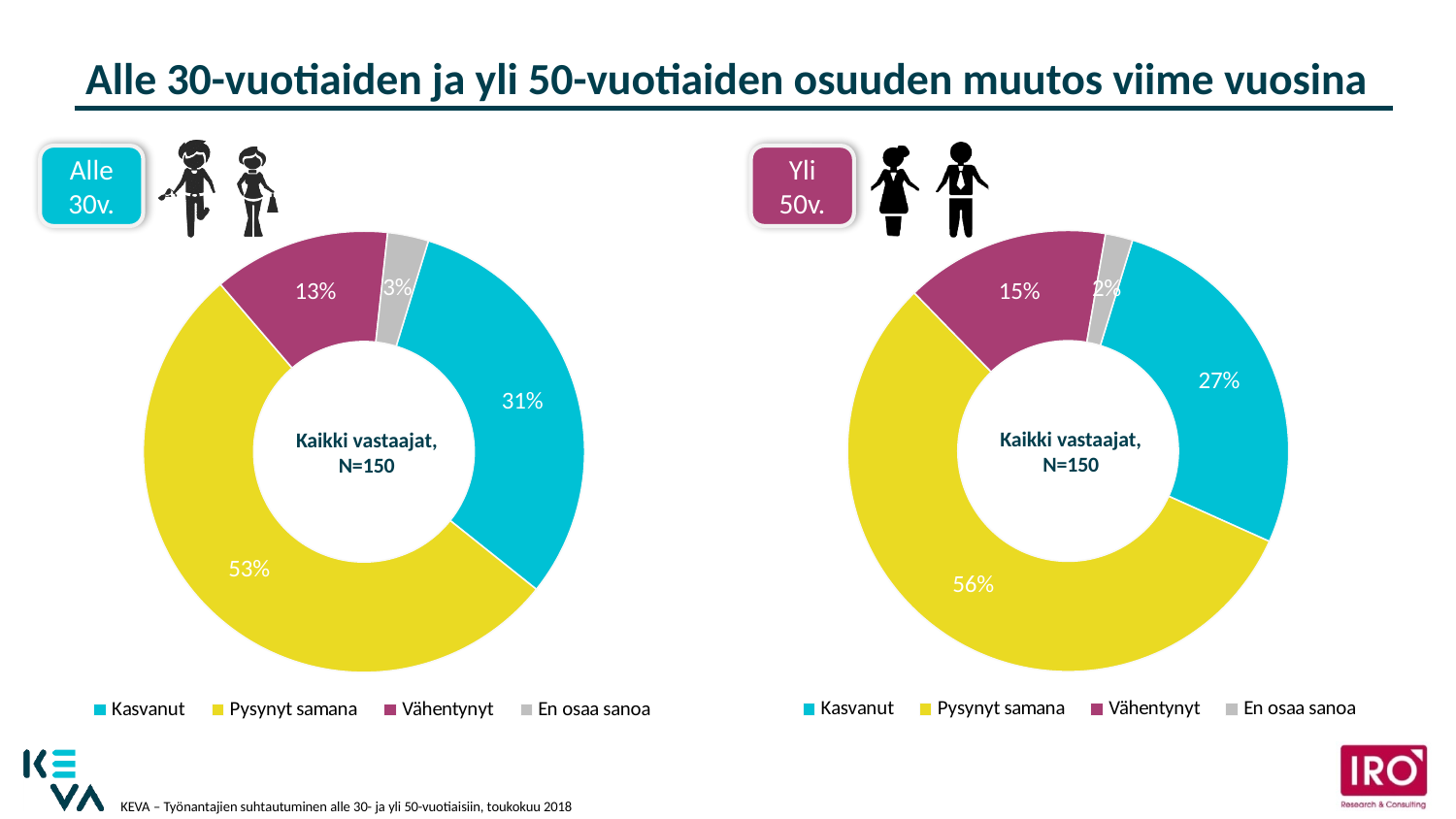
In the right chart (Yli 50v.), what share of respondents answered Kasvanut? 27% What kind of chart is used on this slide? Donut (pie) chart In the right chart (Yli 50v.), what colour represents Pysynyt samana? Yellow In the left chart (Alle 30v.), which category has the largest share? Pysynyt samana In the left chart (Alle 30v.), what share of respondents answered Kasvanut? 31% In the right chart (Yli 50v.), which category has the smallest share? En osaa sanoa In the right chart (Yli 50v.), what share of respondents answered Vähentynyt? 15% How many categories does the legend of the left chart (Alle 30v.) list? 4 In the left chart (Alle 30v.), what is the difference in percentage points between Pysynyt samana and Kasvanut? 22 In the left chart (Alle 30v.), what share of respondents answered Pysynyt samana? 53% What is the number of respondents (N) shown in the centre of the right chart (Yli 50v.)? N=150 Which chart shows a larger share for Kasvanut, the left chart (Alle 30v.) or the right chart (Yli 50v.)? Left chart (Alle 30v.)